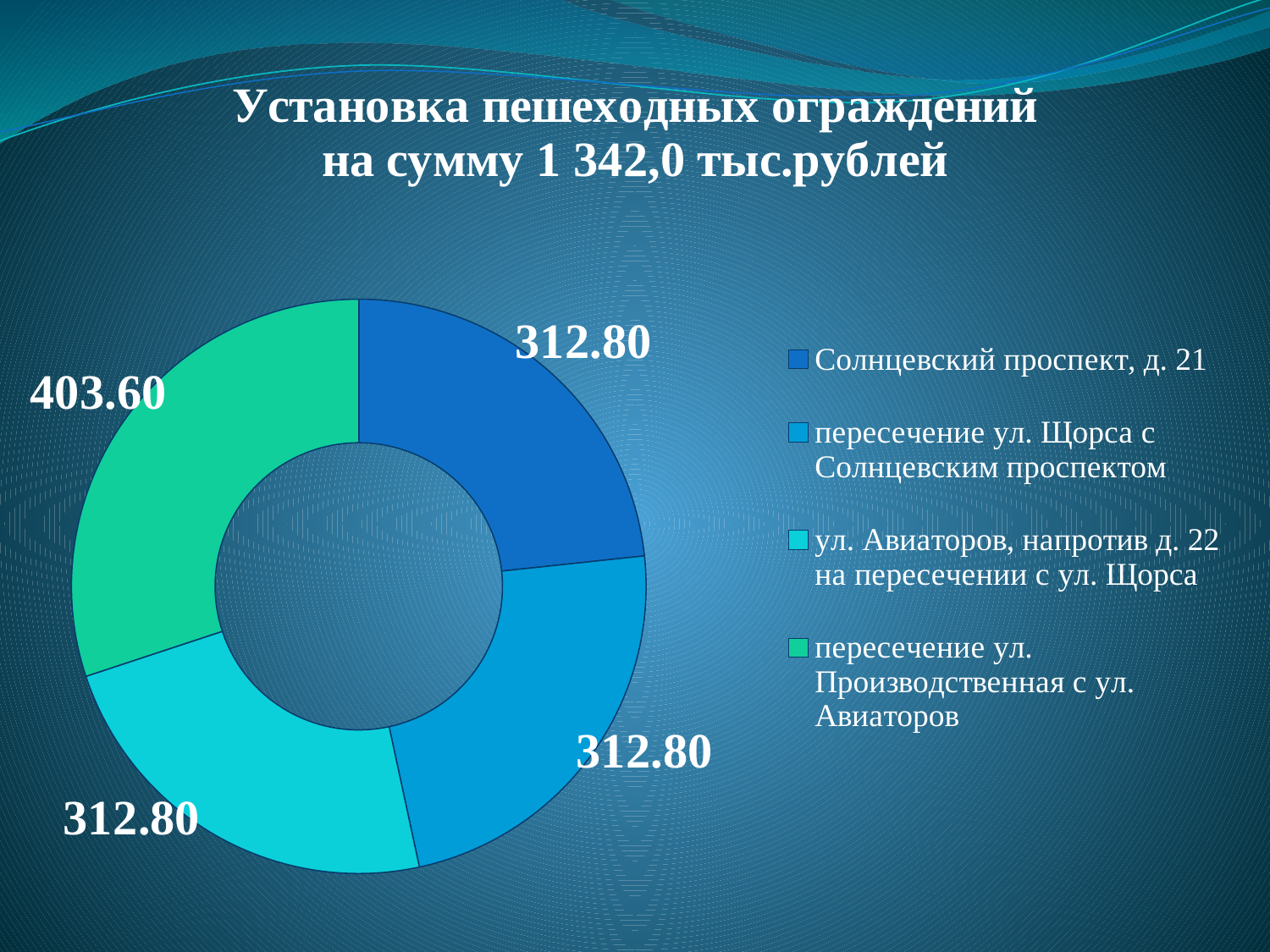
How many categories are shown in the chart? 4 Which colour represents пересечение ул. Производственная с ул. Авиаторов in the legend? Green What is the difference between the value for пересечение ул. Производственная с ул. Авиаторов and the value for Солнцевский проспект, д. 21? 90.80 What is the value for Солнцевский проспект, д. 21? 312.80 What is the value for пересечение ул. Производственная с ул. Авиаторов? 403.60 What is the total of all the values shown in the chart? 1342.00 What kind of chart is shown on the slide? Doughnut (pie) chart Which category has the highest value? пересечение ул. Производственная с ул. Авиаторов What is the value for ул. Авиаторов, напротив д. 22 на пересечении с ул. Щорса? 312.80 Which is larger: the value for пересечение ул. Производственная с ул. Авиаторов or the value for пересечение ул. Щорса с Солнцевским проспектом? пересечение ул. Производственная с ул. Авиаторов What is the title of the slide? Установка пешеходных ограждений на сумму 1 342,0 тыс.рублей